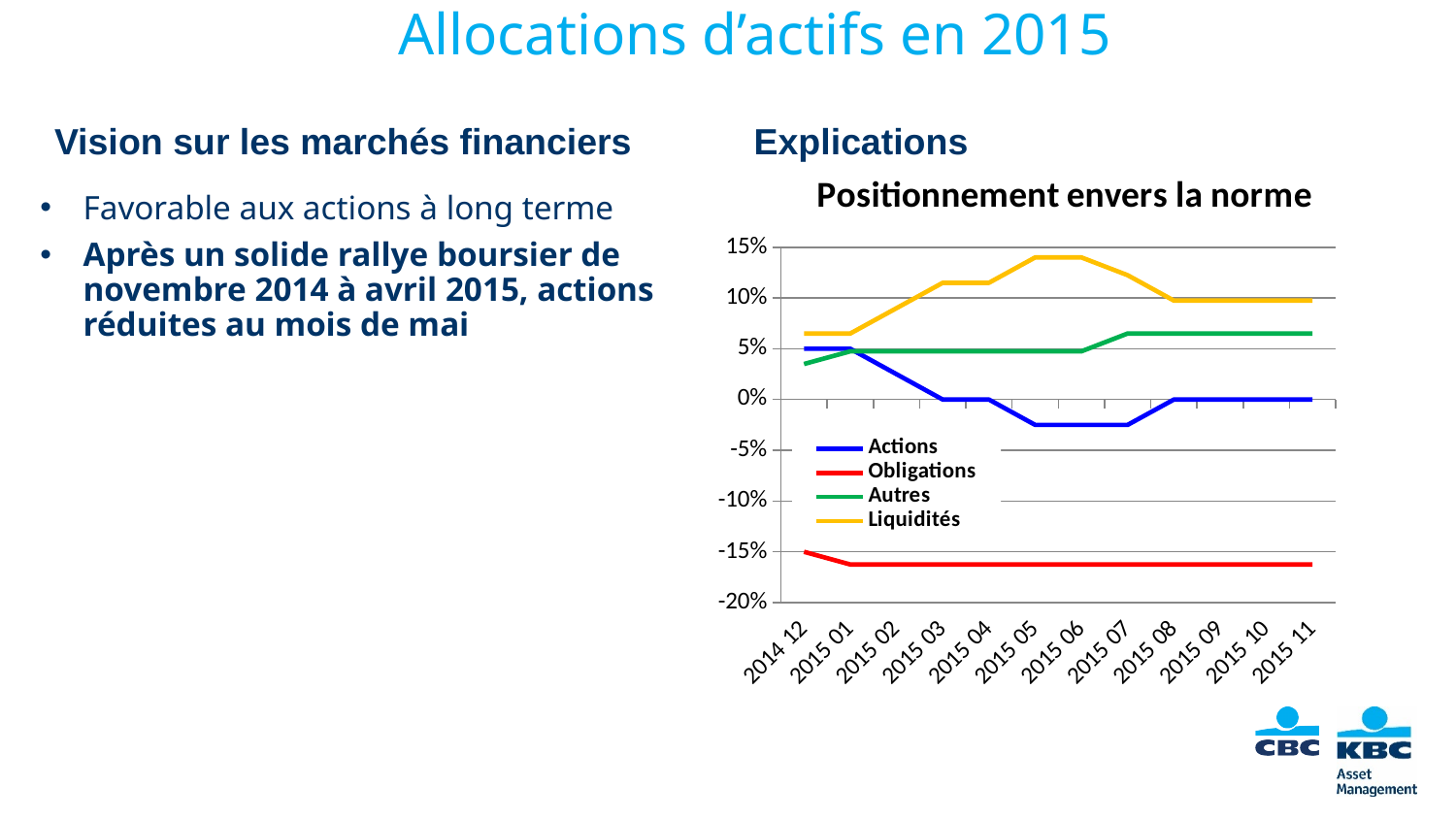
Does the Actions series rise or fall between 2015 01 and 2015 03? fall What colour is the Autres line in the "Positionnement envers la norme" chart? green Does the Liquidités series rise or fall between 2015 06 and 2015 08? fall Which is larger at 2015 11, the value for Liquidités or the value for Autres? Liquidités Which series has the lowest values throughout the "Positionnement envers la norme" chart? Obligations Is the value for Actions at 2015 06 greater or less than -5%? greater How many time points are shown on the x axis of the "Positionnement envers la norme" chart? 12 Which series reaches the highest value in the "Positionnement envers la norme" chart? Liquidités Is the value for Obligations at 2015 05 greater or less than -15%? less How many series does the legend of the "Positionnement envers la norme" chart list? 4 What kind of chart is shown under "Positionnement envers la norme"? line chart Is the value for Liquidités at 2015 06 greater or less than 10%? greater